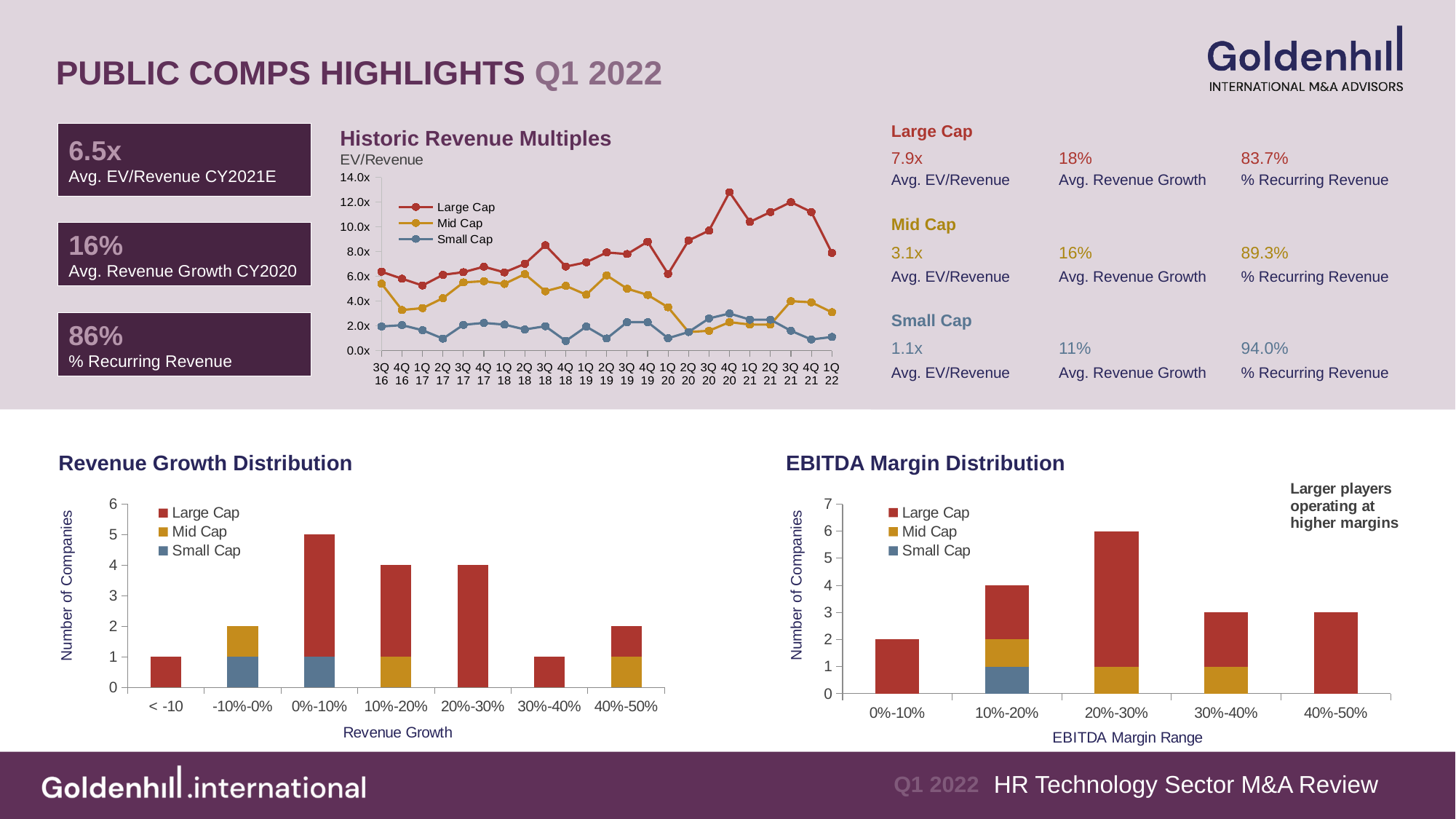
In the Historic Revenue Multiples chart, is the Small Cap value at 1Q 22 greater or less than 2.0x? less In the Historic Revenue Multiples chart, which series has the highest values across the whole period? Large Cap How many series does the legend of the Historic Revenue Multiples chart list? 3 In the EBITDA Margin Distribution chart, what is the difference in number of companies between the 20%-30% bar and the 0%-10% bar? 4 In the EBITDA Margin Distribution chart, what is the total number of companies in the 10%-20% bar? 4 How many quarters are plotted on the x axis of the Historic Revenue Multiples chart? 23 In the EBITDA Margin Distribution chart, which EBITDA margin range has the most companies? 20%-30% In the Historic Revenue Multiples chart, is the Large Cap value at 4Q 20 greater or less than 12.0x? greater In the Revenue Growth Distribution chart, which revenue growth range has the most companies? 0%-10% How many revenue growth ranges are shown on the x axis of the Revenue Growth Distribution chart? 7 In the Revenue Growth Distribution chart, what is the total number of companies in the 0%-10% bar? 5 What kind of chart is the Historic Revenue Multiples chart? line chart